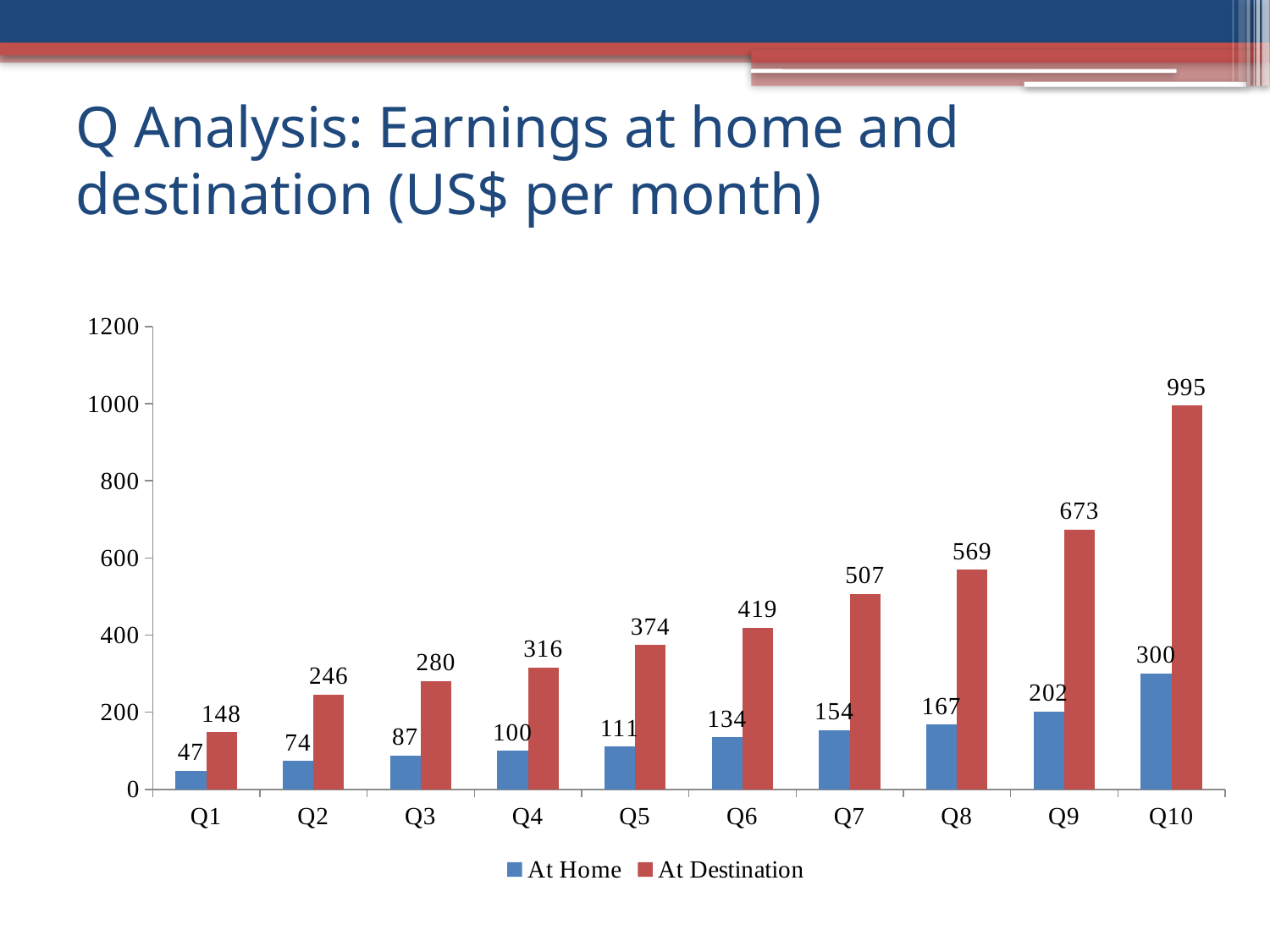
How many series does the legend list? 2 Which category has the highest At Destination value? Q10 What is the At Home value for Q5? 111 Is the At Destination value for Q9 greater or less than 600? greater Which category has the lowest At Home value? Q1 Which is larger: the At Home value for Q10 or the At Destination value for Q3? At Home value for Q10 What kind of chart is shown on the slide? Bar chart What is the difference between the At Destination and At Home values for Q7? 353 What is the At Destination value for Q10? 995 Which colour represents the At Destination series? Red How many categories are shown on the x axis? 10 Do the At Home values rise or fall from Q1 to Q10? Rise